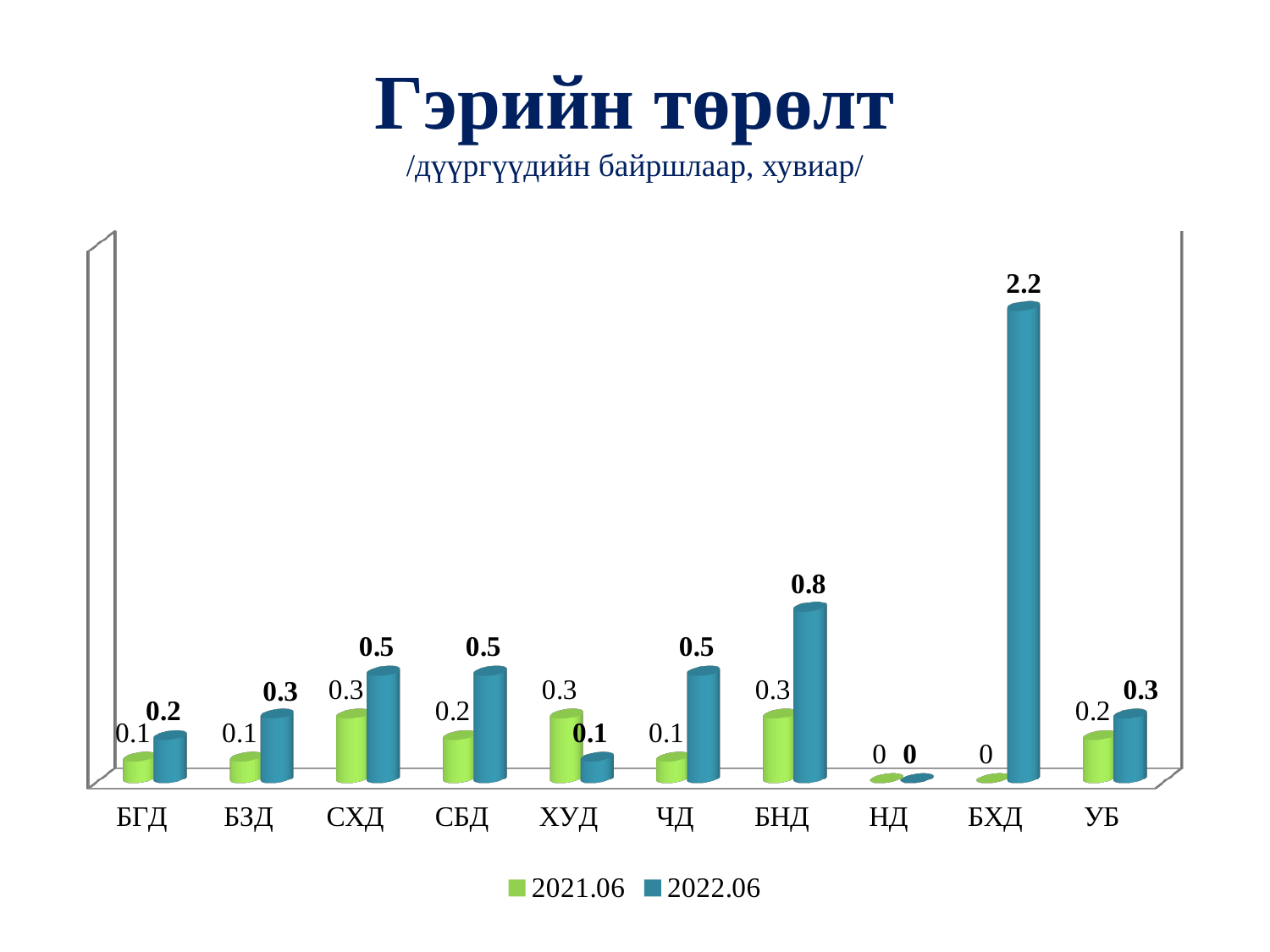
What is the difference between the 2022.06 and 2021.06 values for БНД? 0.5 What is the value for БХД in the 2022.06 series? 2.2 What is the value for ХУД in the 2022.06 series? 0.1 What kind of chart is shown on the slide? Bar chart For ХУД, which series has the larger value, 2021.06 or 2022.06? 2021.06 What is the difference between the 2022.06 values for БХД and БНД? 1.4 How many categories are shown on the x axis? 10 Which category has the highest value in the 2022.06 series? БХД How many series does the legend list? 2 For ЧД, which series has the larger value, 2021.06 or 2022.06? 2022.06 What is the value for БНД in the 2021.06 series? 0.3